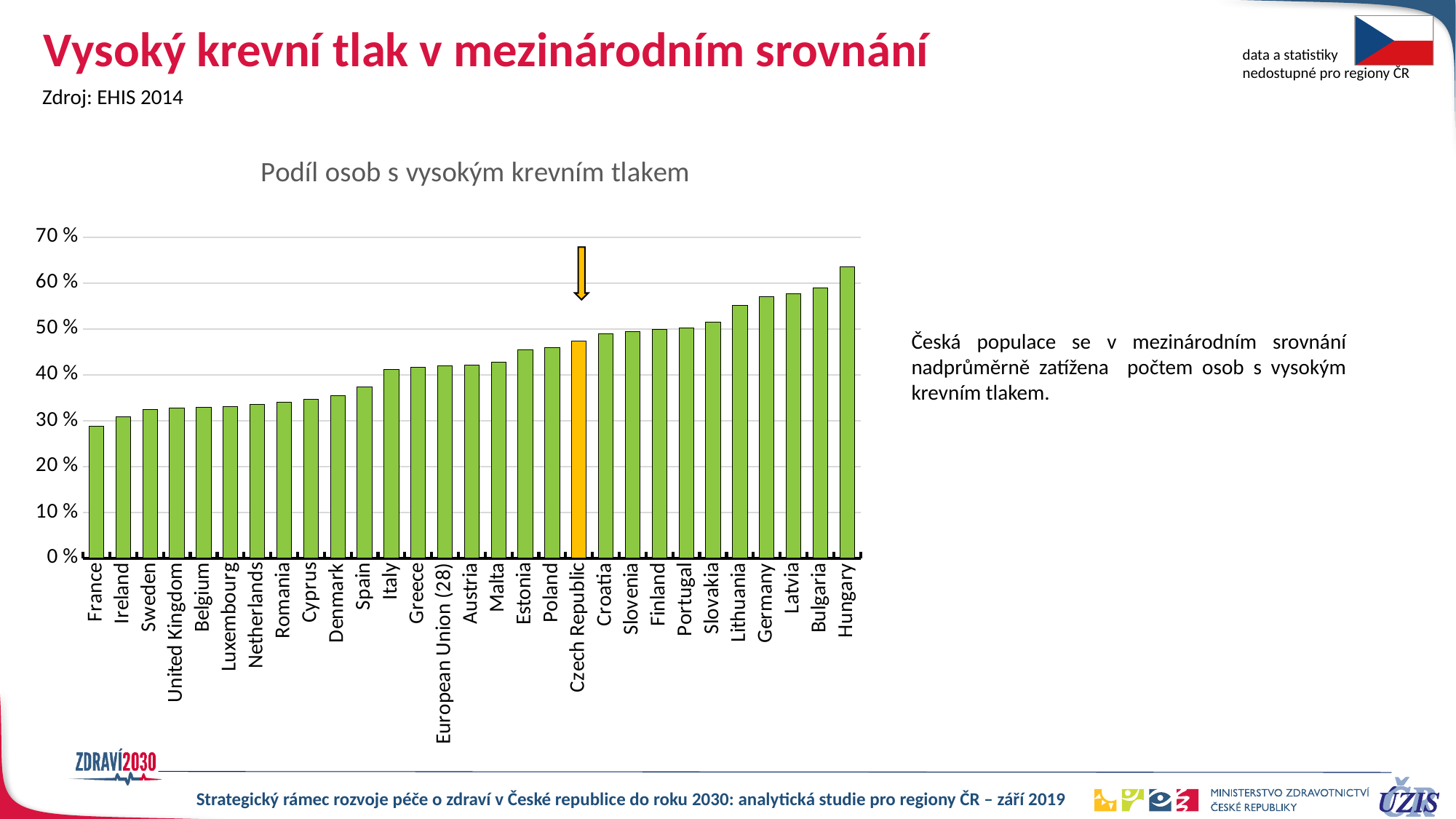
What kind of chart is shown on the slide? Bar chart Which country has the highest share of persons with high blood pressure in the chart? Hungary Is the value for France greater or less than 30 %? less Is the value for Lithuania greater or less than 50 %? greater How many categories (bars) are plotted in the chart? 29 Which country has the lowest share of persons with high blood pressure in the chart? France What is the title of the chart? Podíl osob s vysokým krevním tlakem Which has a larger value, Czech Republic or European Union (28)? Czech Republic Is the value for Hungary greater or less than 60 %? greater Which has a larger value, Italy or Germany? Germany Do the values rise or fall from left to right along the x axis? Rise